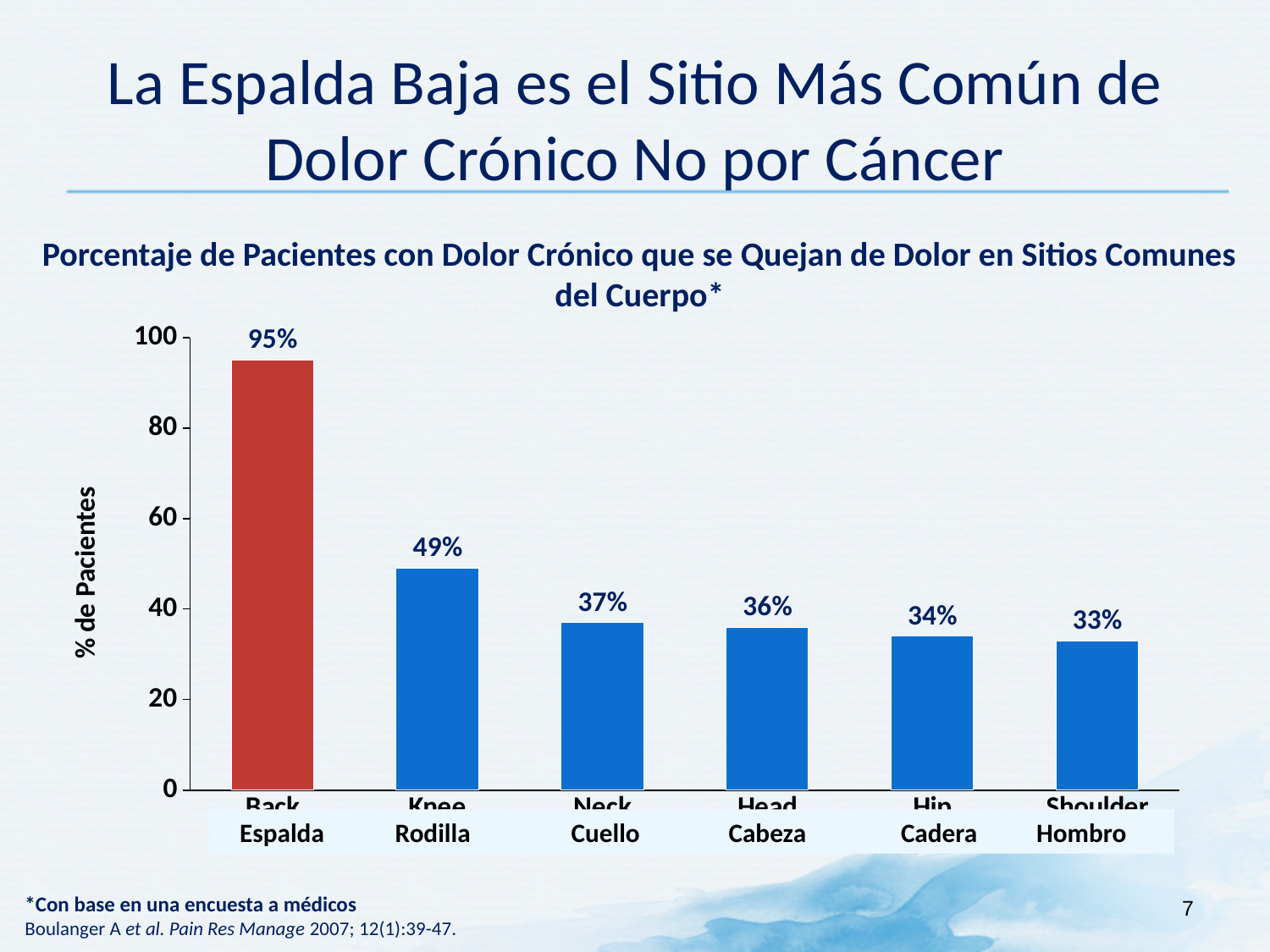
What percentage of patients is shown for Espalda? 95% What kind of chart is shown on the slide? Bar chart What is the difference between the values for Cuello and Hombro? 4% How many body sites are shown in the chart? 6 What value is shown for Cadera? 34% What value is shown for Rodilla? 49% Is the value for Cuello greater or less than 40? less What is the label of the y axis? % de Pacientes Which is larger, the value for Rodilla or the value for Cabeza? Rodilla Which body site has the highest percentage of patients? Espalda What is the difference between the values for Espalda and Rodilla? 46% Which body site has the lowest percentage of patients? Hombro